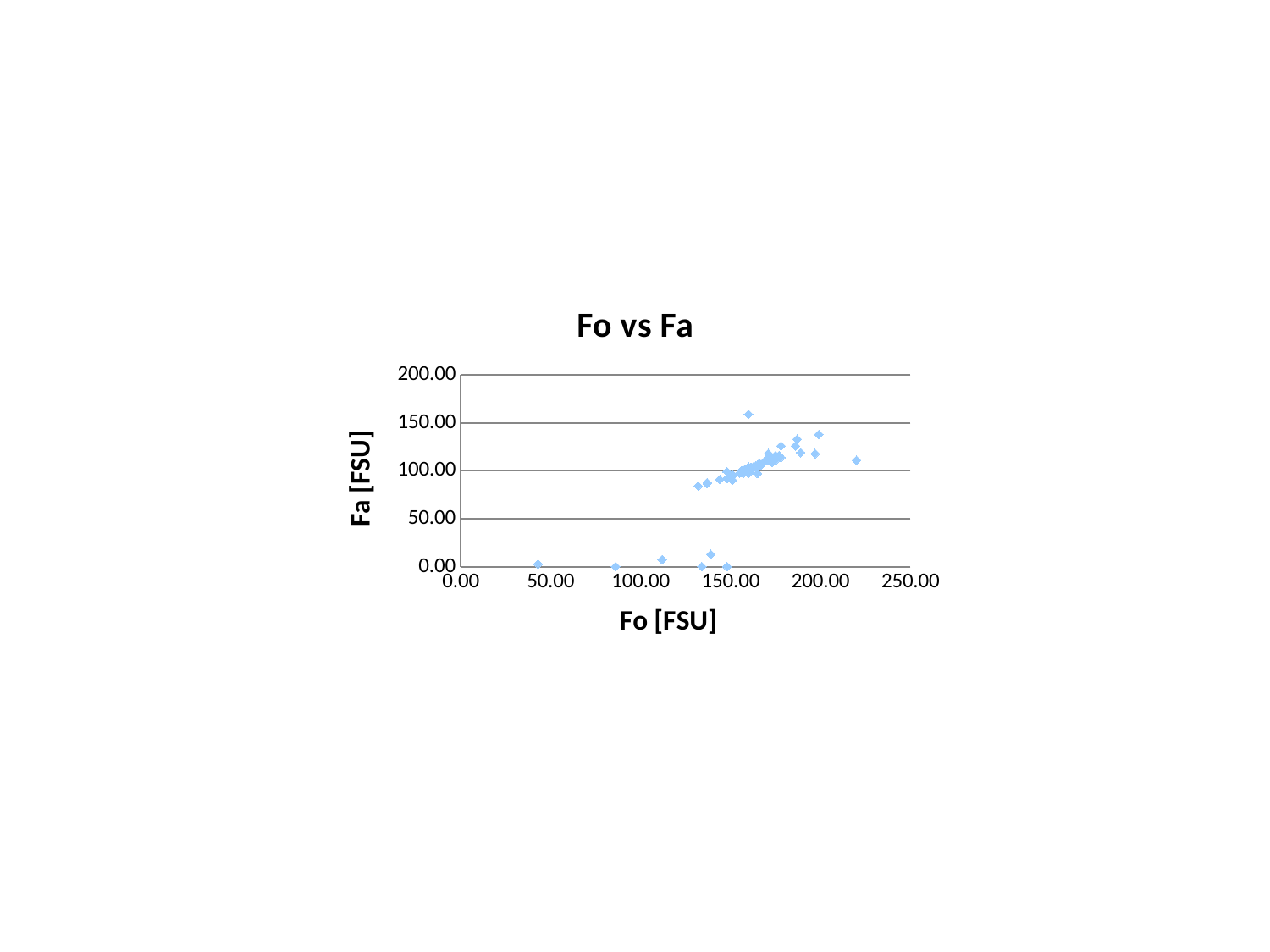
What kind of chart is shown on the slide? scatter plot What is the label of the vertical axis? Fa [FSU] What is the title of the chart? Fo vs Fa Within the main cluster of points, does Fa generally rise or fall as Fo increases? rise Is the Fa value of the highest point on the chart greater or less than 200.00? less Is the Fa value of the rightmost point (near Fo 220) greater or less than 100.00? greater What is the highest value shown on the horizontal axis? 250.00 Are the points near the bottom of the chart (Fa close to 0) above or below 50.00 on the Fa axis? below What is the highest value shown on the vertical axis? 200.00